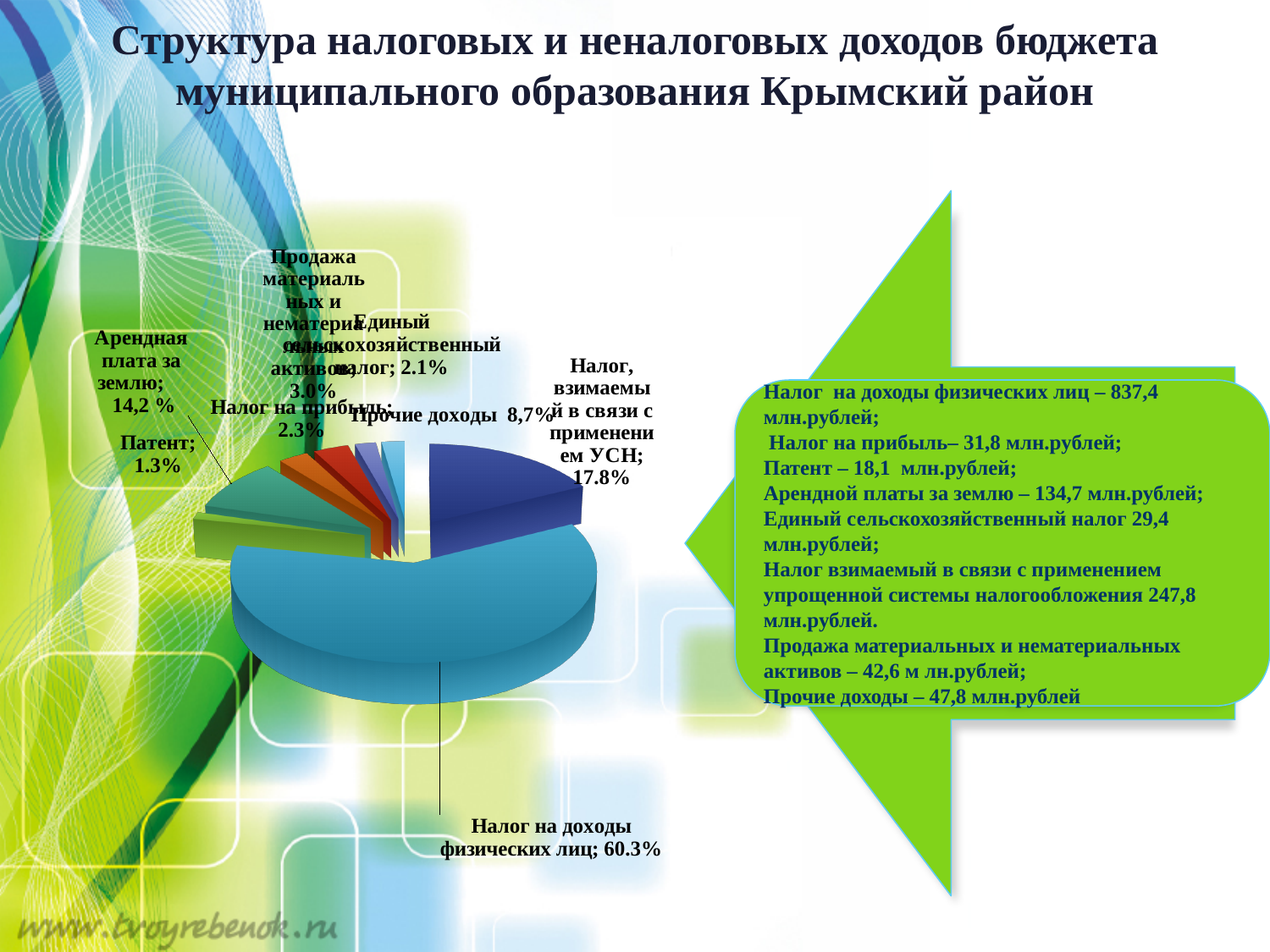
What share of the pie does "Налог на доходы физических лиц" have? 60.3% Which category has the smallest slice of the pie? Патент What percentage is shown for "Налог, взимаемый в связи с применением УСН"? 17.8% What percentage is shown for "Налог на прибыль"? 2.3% What percentage is shown for "Патент"? 1.3% By how many percentage points does "Налог на доходы физических лиц" exceed "Налог, взимаемый в связи с применением УСН"? 42.5 What percentage is shown for "Арендная плата за землю"? 14,2 % How many slices does the pie chart have? 8 What kind of chart is shown on the slide? Pie chart Which is larger: the share for "Арендная плата за землю" or the share for "Прочие доходы"? Арендная плата за землю What percentage is shown for "Прочие доходы"? 8,7% Which category has the largest slice of the pie? Налог на доходы физических лиц